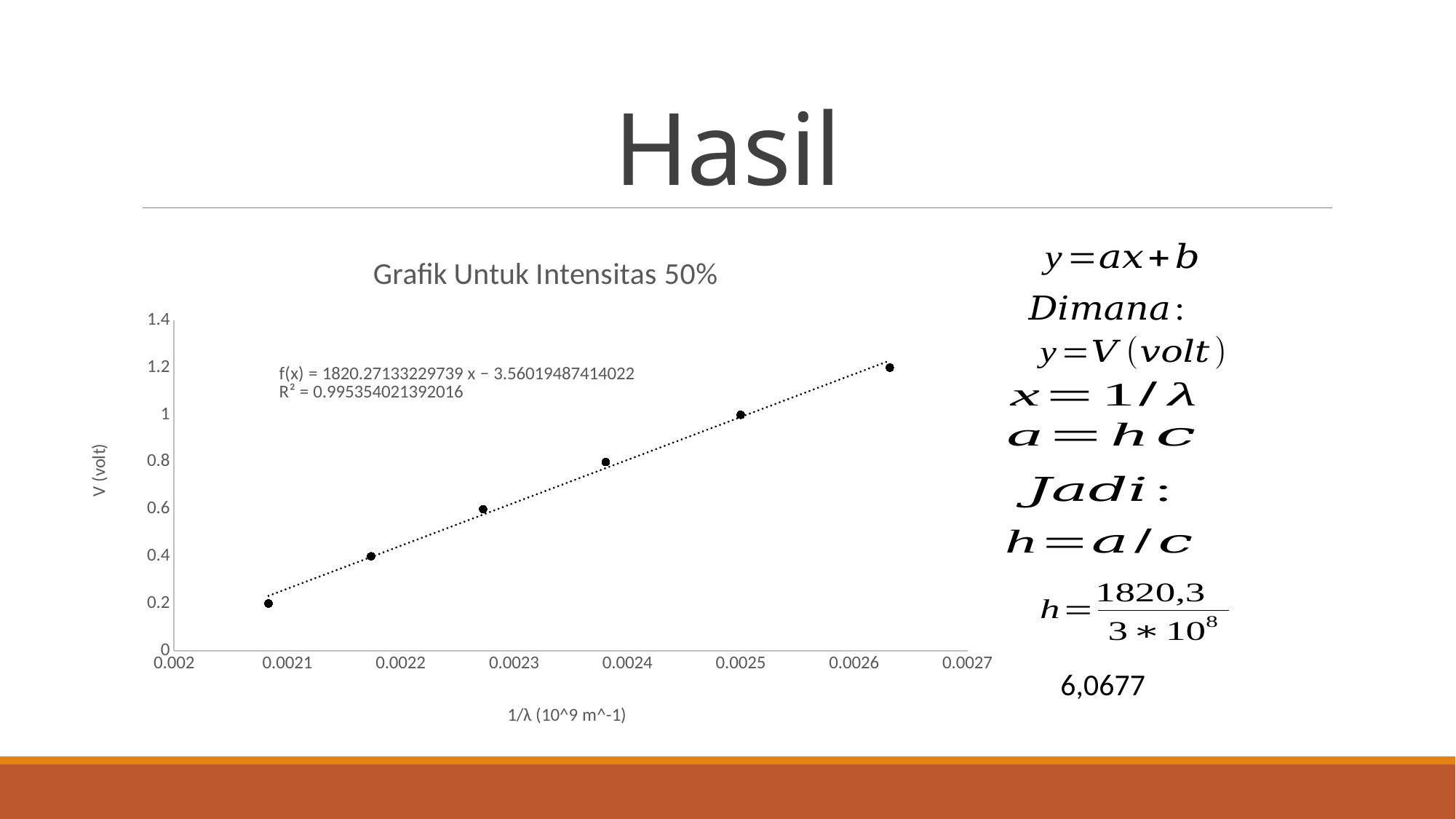
Is the V (volt) value of the data point near 1/λ = 0.0025 greater or less than 0.8? greater What is the V (volt) value of the highest data point in the chart? 1.2 What kind of chart is shown on the slide? scatter chart Is the V (volt) value of the rightmost data point greater or less than 1? greater Is the V (volt) value of the leftmost data point greater or less than 0.4? less Do the V (volt) values rise or fall as 1/λ increases along the x axis? rise How many data points are plotted in the chart? 6 What is the title of the chart? Grafik Untuk Intensitas 50% What R² value is printed on the chart? 0.995354021392016 What is the V (volt) value of the lowest data point in the chart? 0.2 Which data point has a larger V (volt) value: the one near 1/λ = 0.0024 or the one near 1/λ = 0.0022? the one near 0.0024